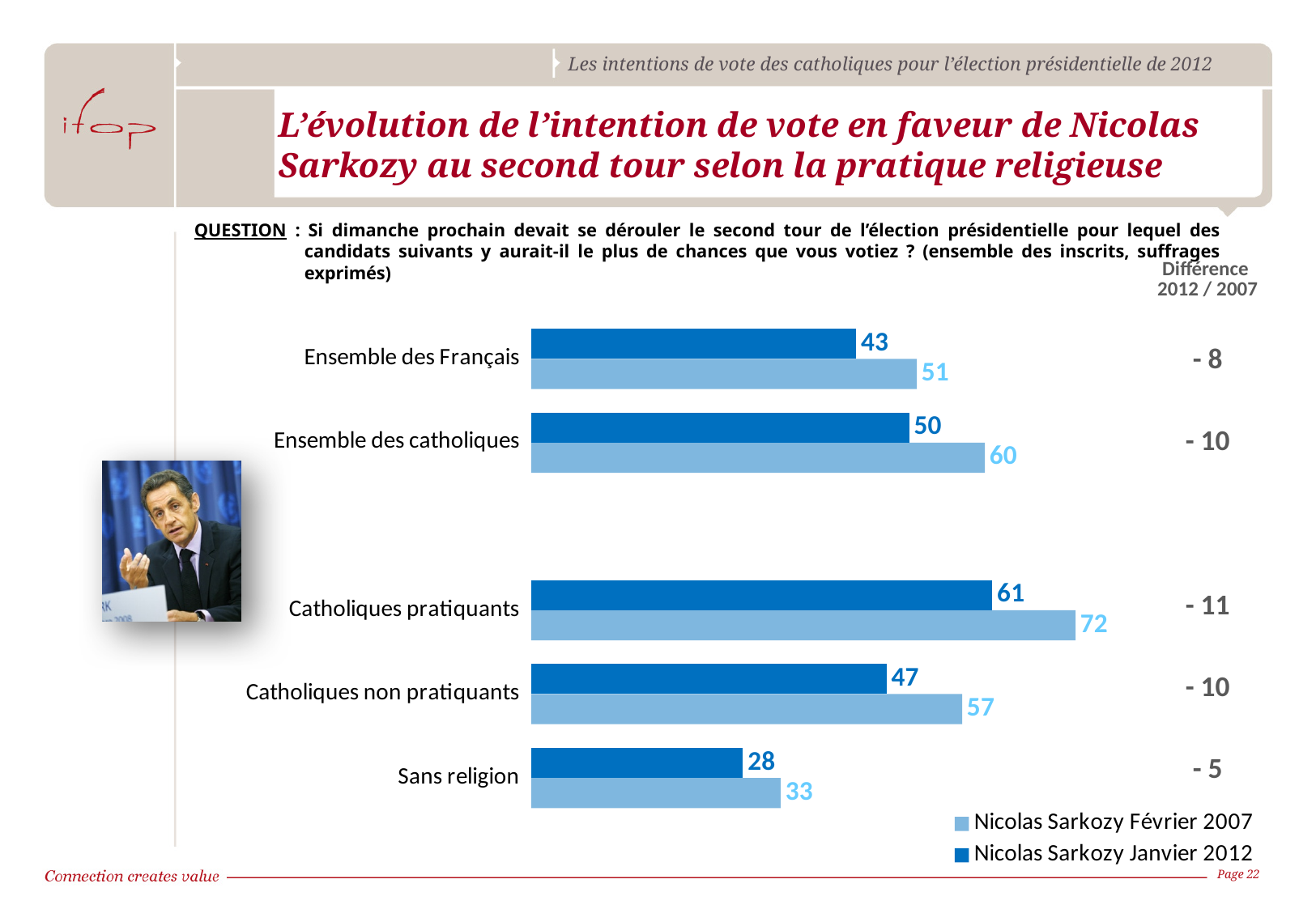
What is the value for Ensemble des catholiques in the Nicolas Sarkozy Janvier 2012 series? 50 Which series is shown in the darker blue colour? Nicolas Sarkozy Janvier 2012 What is the difference between the Février 2007 and Janvier 2012 values for Catholiques non pratiquants? 10 What is the value for Catholiques pratiquants in the Nicolas Sarkozy Février 2007 series? 72 Which category has the highest value in the Nicolas Sarkozy Janvier 2012 series? Catholiques pratiquants How many categories are shown on the chart? 5 What is the 'Différence 2012 / 2007' shown for Ensemble des Français? - 8 What is the value for Sans religion in the Nicolas Sarkozy Janvier 2012 series? 28 What kind of chart is shown on the slide? Bar chart Which category has the lowest value in the Nicolas Sarkozy Février 2007 series? Sans religion How many series does the legend list? 2 Which is larger: the Janvier 2012 value for Ensemble des Français or the Janvier 2012 value for Catholiques non pratiquants? Catholiques non pratiquants